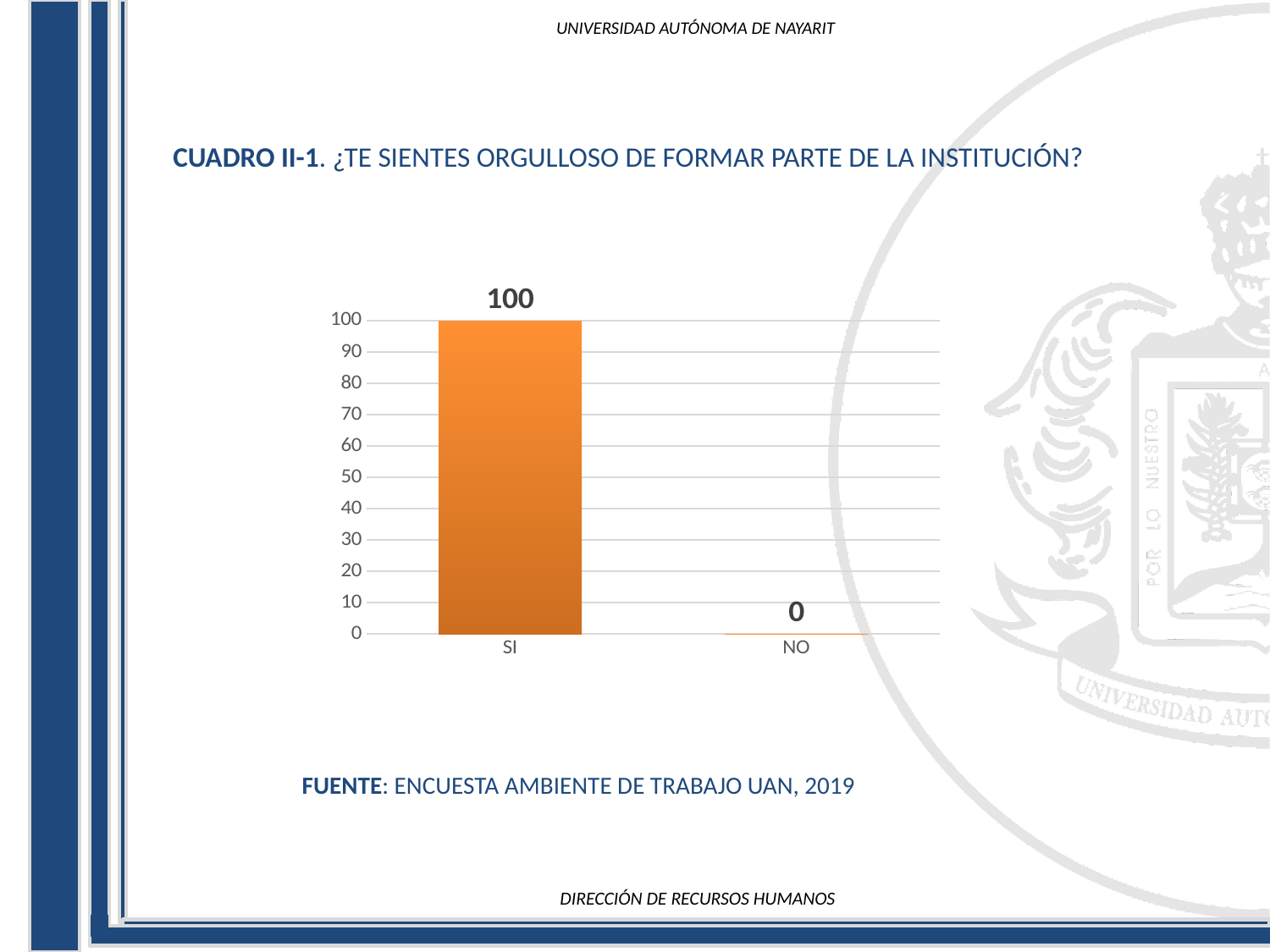
How many categories are shown on the x axis? 2 What is the value for SI? 100 Which is larger, the value for SI or the value for NO? SI What is the difference between the values for SI and NO? 100 Which category has the highest value? SI What is the maximum value shown on the vertical axis? 100 What kind of chart is shown on the slide? bar chart What colour is the bar for SI? orange Which category has the lowest value? NO Is the value for SI greater or less than 50? greater What is the value for NO? 0